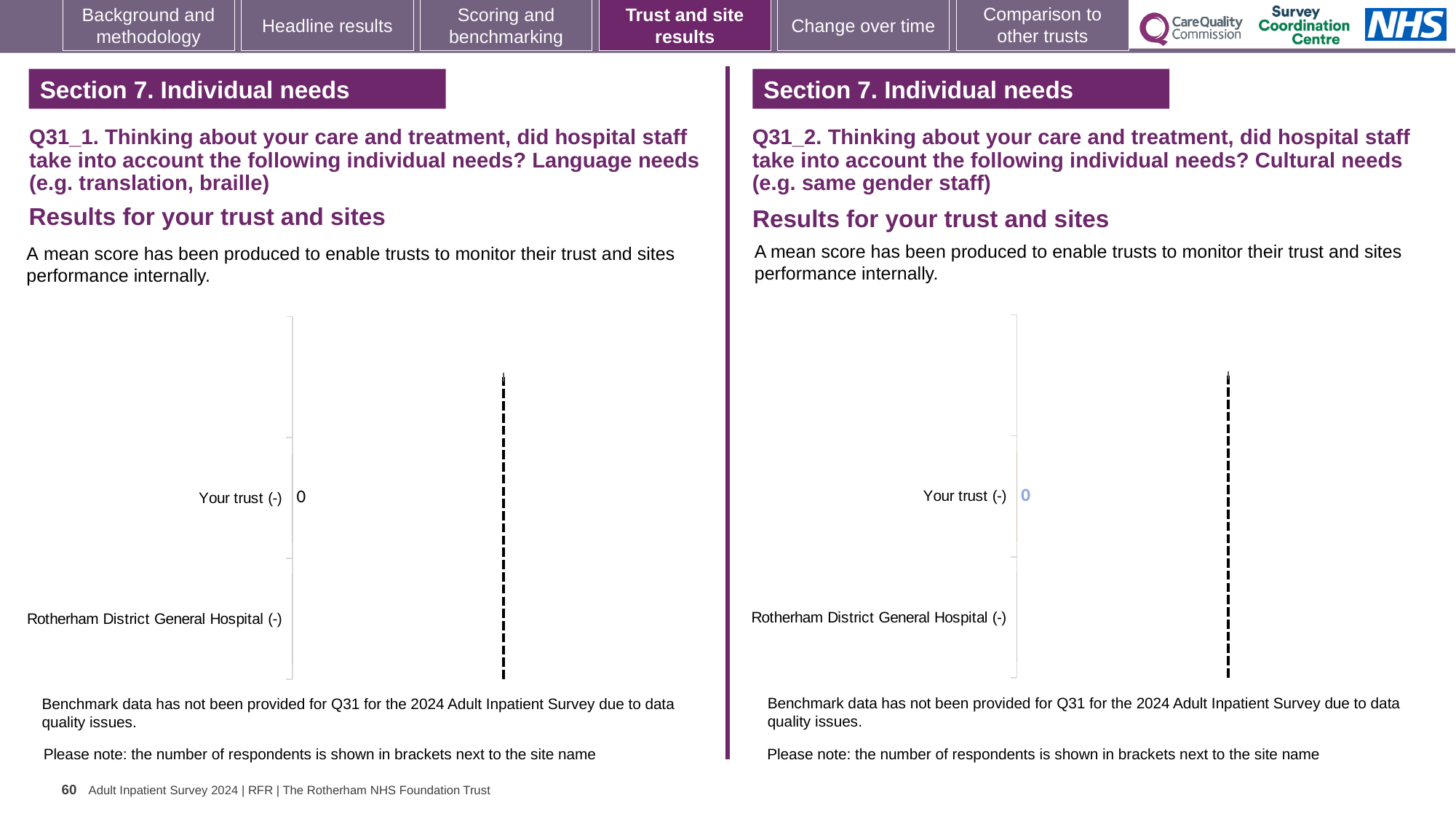
On the right chart (Q31_2, Cultural needs), which individual need does the question text refer to? Cultural needs (e.g. same gender staff) How many categories are listed on the right chart (Q31_2, Cultural needs)? 2 How many categories are listed on the left chart (Q31_1, Language needs)? 2 On the right chart (Q31_2, Cultural needs), what value is shown for Your trust? 0 On the left chart (Q31_1, Language needs), what value is shown for Your trust? 0 What kind of chart is the left chart (Q31_1, Language needs)? Bar chart On the left chart (Q31_1, Language needs), what is the label of the category listed below Your trust? Rotherham District General Hospital (-) What kind of chart is the right chart (Q31_2, Cultural needs)? Bar chart